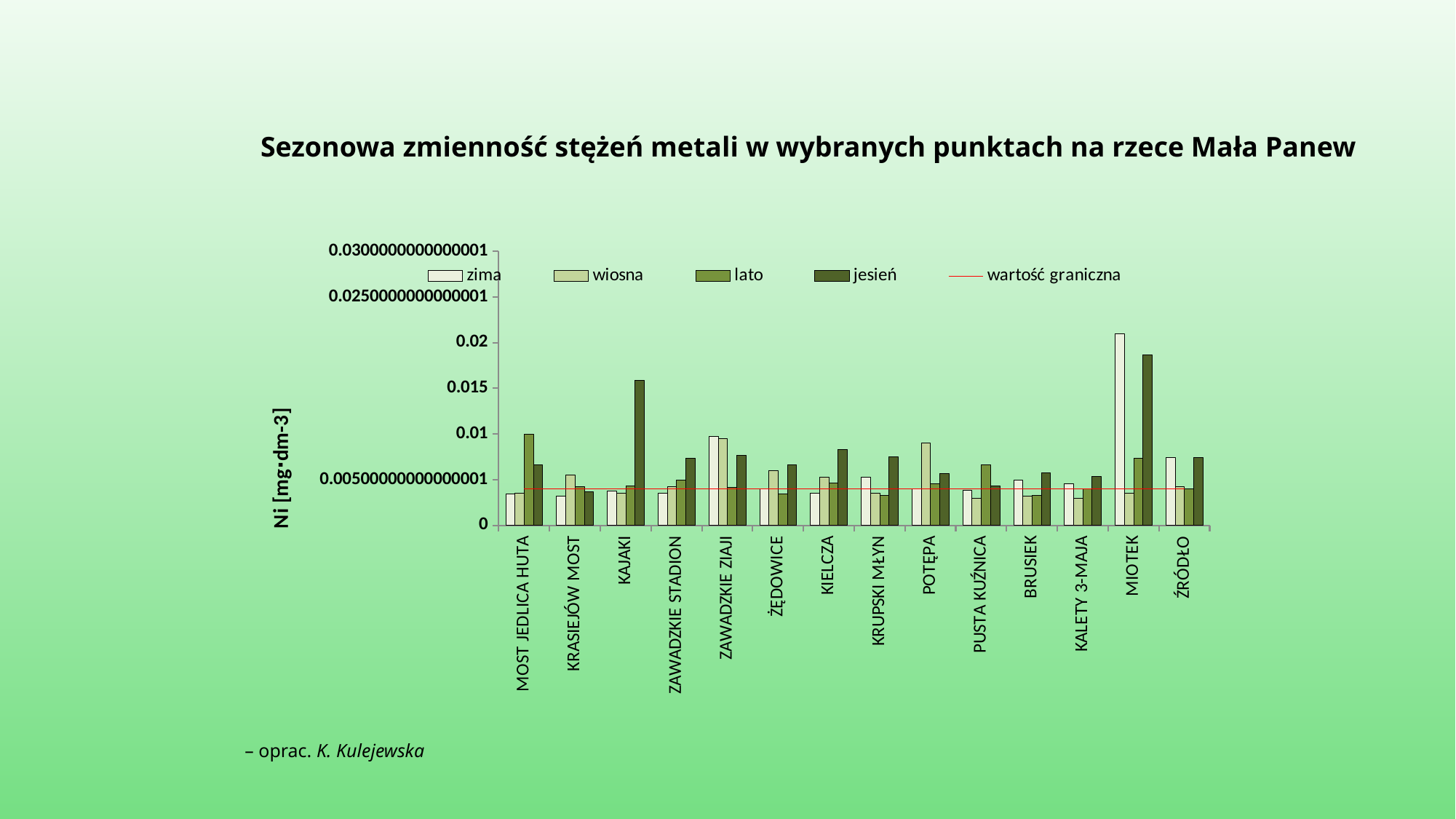
At MIOTEK, which season has the lowest Ni concentration? wiosna What kind of chart is shown on the slide? bar chart At KAJAKI, which season has the highest Ni concentration? jesień Which is larger at POTĘPA: the zima value or the jesień value? jesień What is the label of the vertical axis? Ni [mg·dm-3] Which is larger at MIOTEK: the zima value or the jesień value? zima Is the jesień value for MIOTEK greater or less than 0.02? less Is the jesień value for KAJAKI greater or less than 0.01? greater Which sampling point has the tallest bar in the chart? MIOTEK At MIOTEK, which season has the highest Ni concentration? zima How many entries does the legend list? 5 How many sampling points (categories) are shown on the x axis? 14